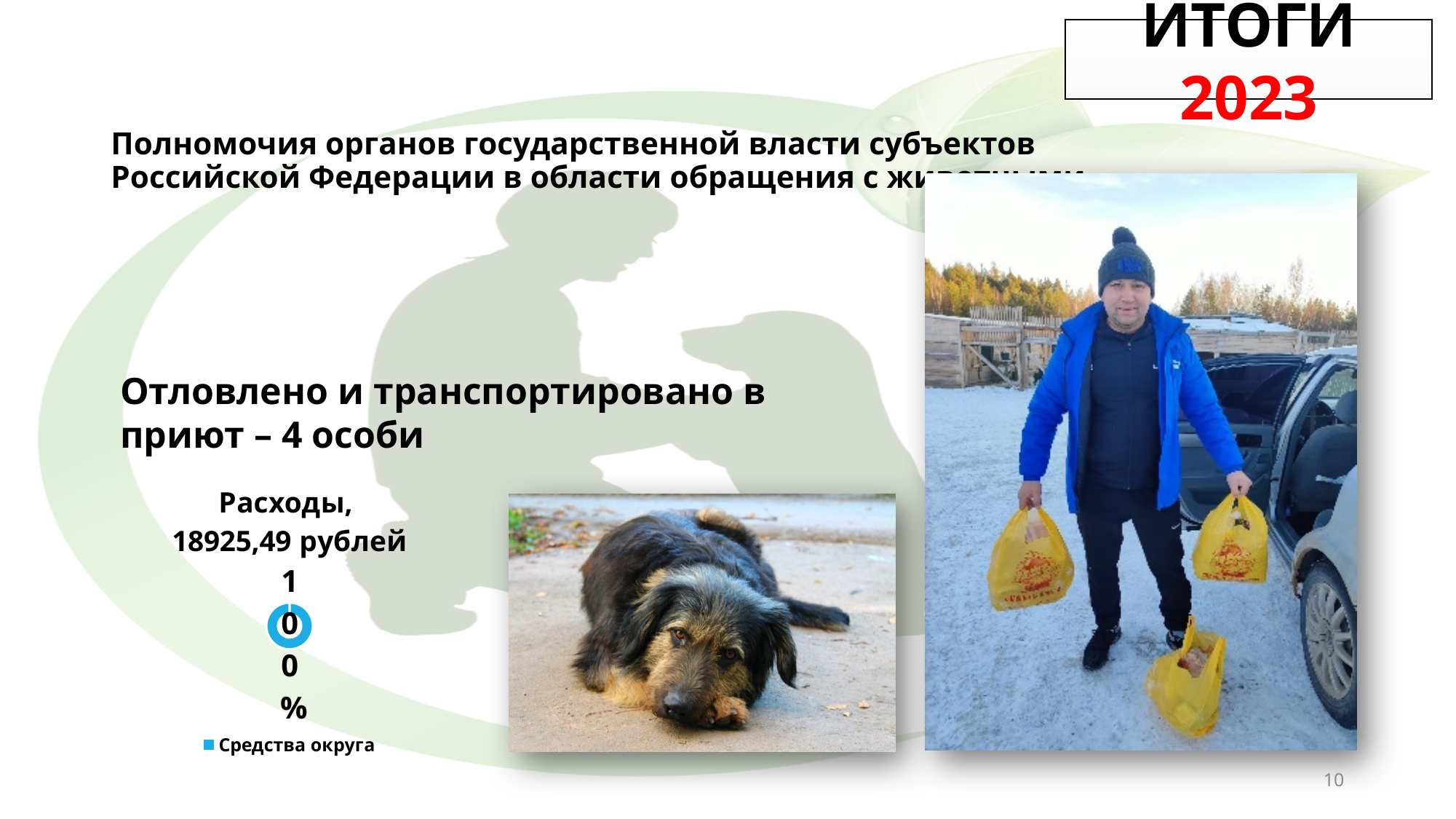
How many slices does the chart have? 1 What kind of chart is shown on the slide? Pie chart (doughnut) How many series does the chart legend list? 1 What is the legend entry of the chart? Средства округа What is the total amount of expenses stated in the chart title? 18925,49 рублей What is the title of the chart on the slide? Расходы, 18925,49 рублей What percentage is printed as the data label on the chart? 100% What share of the chart does the slice "Средства округа" take? 100%